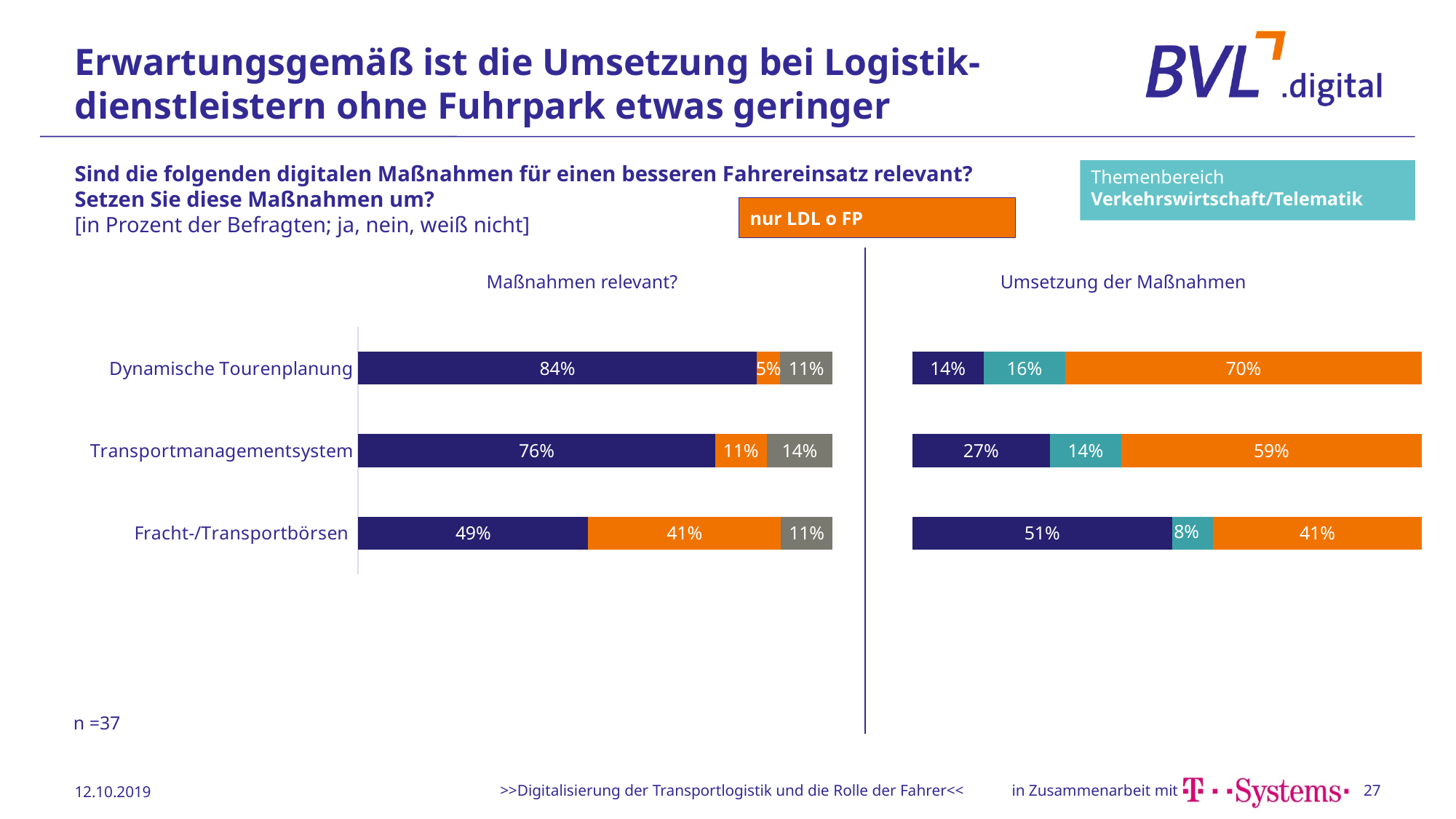
In the "Umsetzung der Maßnahmen" chart, what is the value of the orange segment for Transportmanagementsystem? 59% In the "Umsetzung der Maßnahmen" chart, which category has the smallest dark blue segment? Dynamische Tourenplanung In the "Maßnahmen relevant?" chart, which category has the largest dark blue segment? Dynamische Tourenplanung In the "Maßnahmen relevant?" chart, what is the value of the dark blue segment for Dynamische Tourenplanung? 84% What is the sample size (n) stated on the slide? n =37 In the "Umsetzung der Maßnahmen" chart, what is the value of the teal segment for Fracht-/Transportbörsen? 8% What type of chart is the "Maßnahmen relevant?" chart? Stacked bar chart In the "Maßnahmen relevant?" chart, is the dark blue segment larger for Transportmanagementsystem or for Fracht-/Transportbörsen? Transportmanagementsystem How many categories are shown in the "Umsetzung der Maßnahmen" chart? 3 In the "Maßnahmen relevant?" chart, what is the total of the three segments for Transportmanagementsystem? 101% In the "Maßnahmen relevant?" chart, what is the value of the orange segment for Fracht-/Transportbörsen? 41% In the "Umsetzung der Maßnahmen" chart, what is the difference between the orange segments for Dynamische Tourenplanung and Fracht-/Transportbörsen? 29%